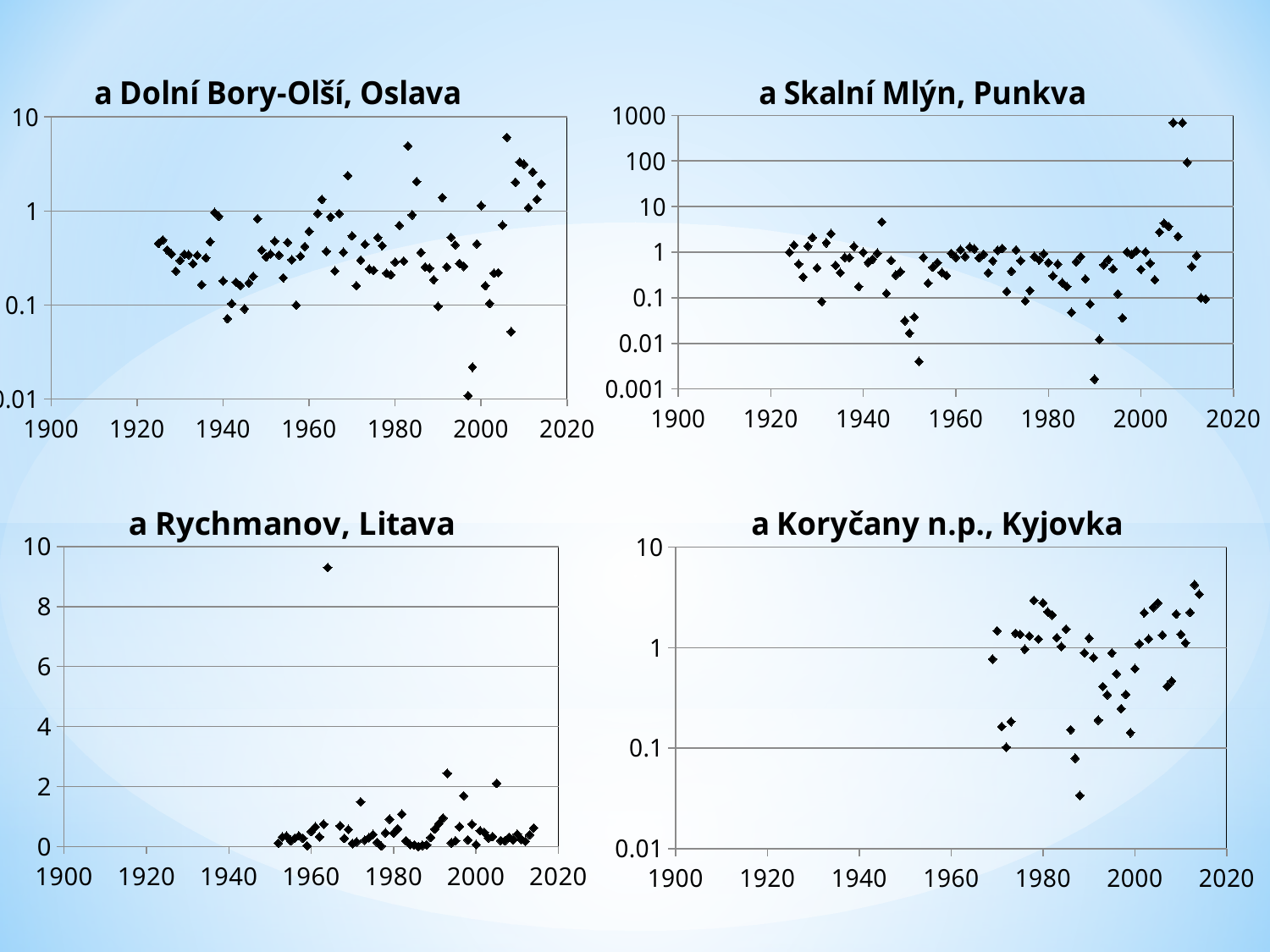
In the chart "a Koryčany n.p., Kyjovka", is the highest plotted value greater or less than 1? greater In the chart "a Dolní Bory-Olší, Oslava", is the highest plotted value greater or less than 1? greater In the chart "a Skalní Mlýn, Punkva", is the lowest plotted value (near 1990) greater or less than 0.01? less Which chart has a y-axis that goes up to 1000? a Skalní Mlýn, Punkva Which of the four charts uses a linear (non-logarithmic) y-axis? a Rychmanov, Litava In the chart "a Rychmanov, Litava", which is larger: the outlier point between 1960 and 1980 or the highest point between 1980 and 2000? the outlier between 1960 and 1980 What kind of chart is "a Dolní Bory-Olší, Oslava"? scatter chart How many charts are shown on the slide? 4